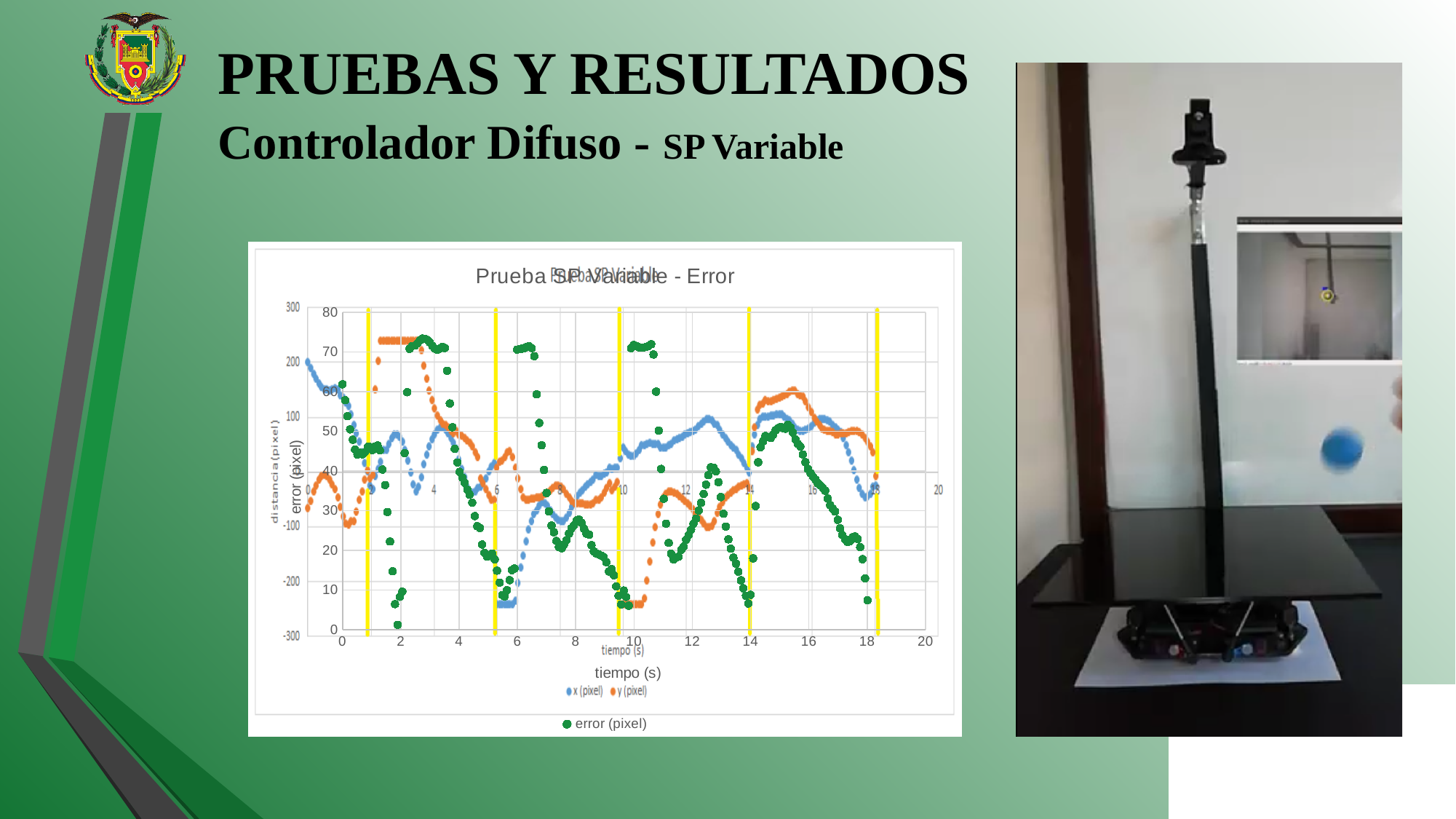
In the front chart, is the error value at about 5.5 s greater or less than 20? less How many series does the legend of the background chart (blue and orange dots) list? 2 What is the title of the front chart with the green dots? Prueba SP Variable - Error What is the label of the x axis of the chart? tiempo (s) In the front chart, is the error value at about 15 s greater or less than 40? greater How many series does the legend of the front chart (green dots) list? 1 In the front chart, is the error value at about 18 s greater or less than 10? less What kind of chart is shown on the slide? scatter chart